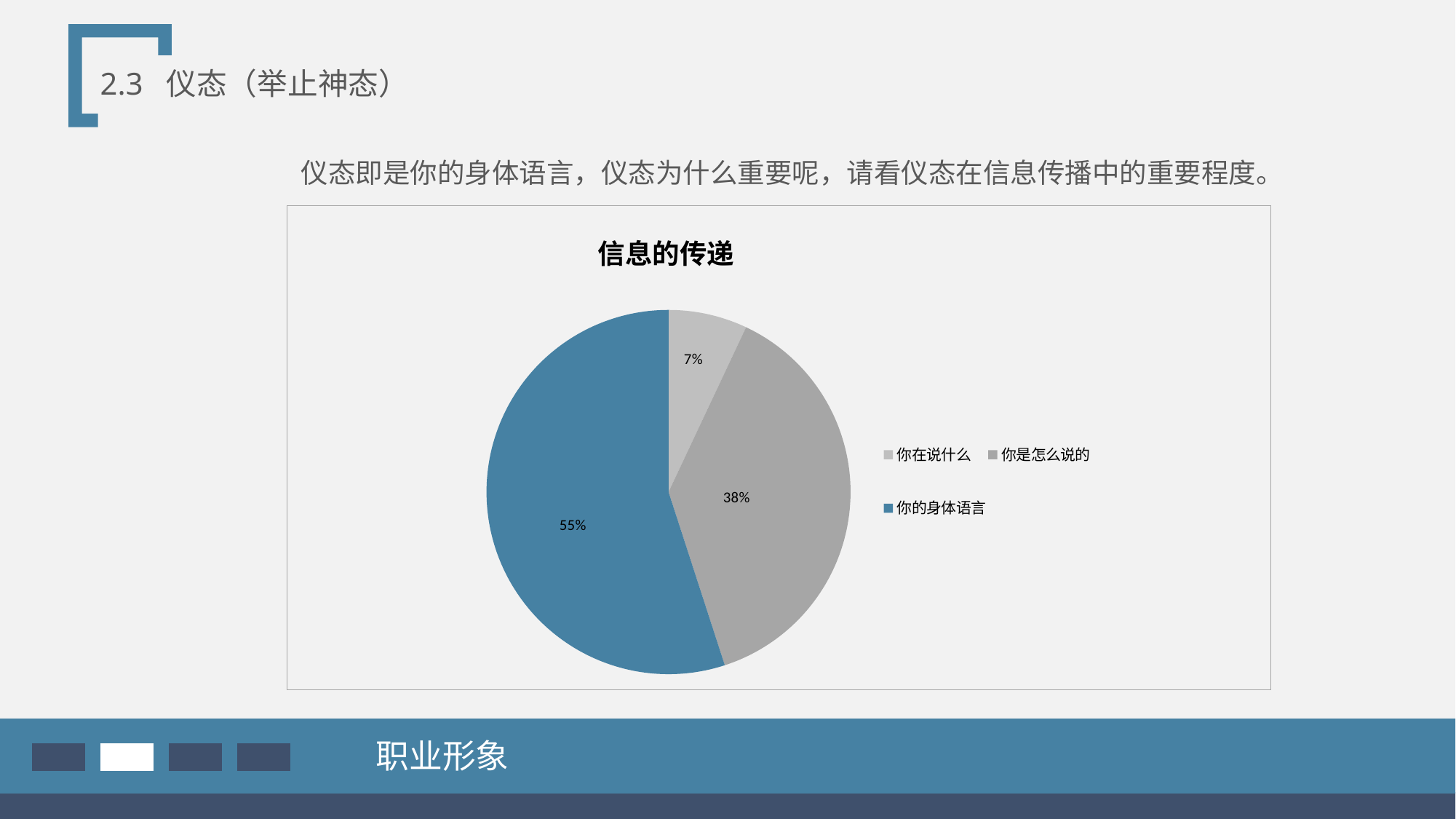
What percentage does the slice for 你是怎么说的 show? 38% How many slices does the pie chart have? 3 Which category is shown in blue in the pie chart? 你的身体语言 What percentage does the slice for 你的身体语言 show? 55% Which category has the smallest slice of the pie? 你在说什么 What type of chart is shown on the slide? pie chart What percentage does the slice for 你在说什么 show? 7% What is the difference between the shares for 你是怎么说的 and 你在说什么? 31% Which is larger, the slice for 你是怎么说的 or the slice for 你在说什么? 你是怎么说的 Which category has the largest slice of the pie? 你的身体语言 What is the difference between the shares for 你的身体语言 and 你是怎么说的? 17% What is the title of the chart? 信息的传递